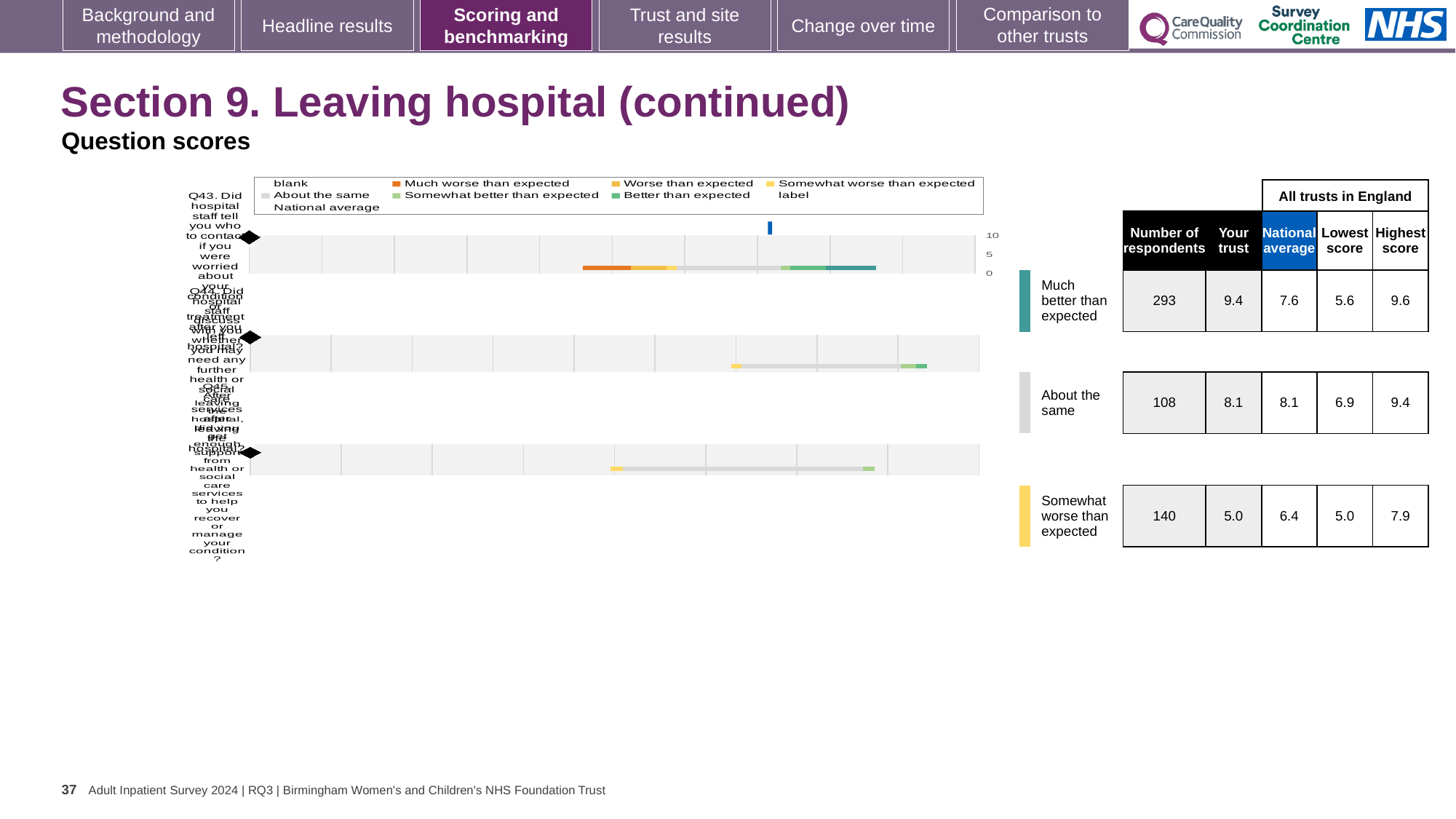
What benchmark category is shown for Q43 (the top row)? Much better than expected What is the 'Your trust' score for Q43 (the top row of the chart)? 9.4 What is the national average score for Q44 (the second row of the chart)? 8.1 Which question row has the lowest 'Your trust' score? Q45 What kind of chart is used to show the question scores on this slide? bar chart What benchmark category is shown for Q45 (the bottom row)? Somewhat worse than expected What is the difference between the 'Your trust' score and the national average for Q43? 1.8 What is the highest score among all trusts in England for Q44? 9.4 How many respondents answered Q45 (the bottom row of the chart)? 140 Which question row has the highest 'Your trust' score? Q43 How many questions (rows) are plotted in the question scores chart? 3 For Q45, is the 'Your trust' score or the national average larger? National average